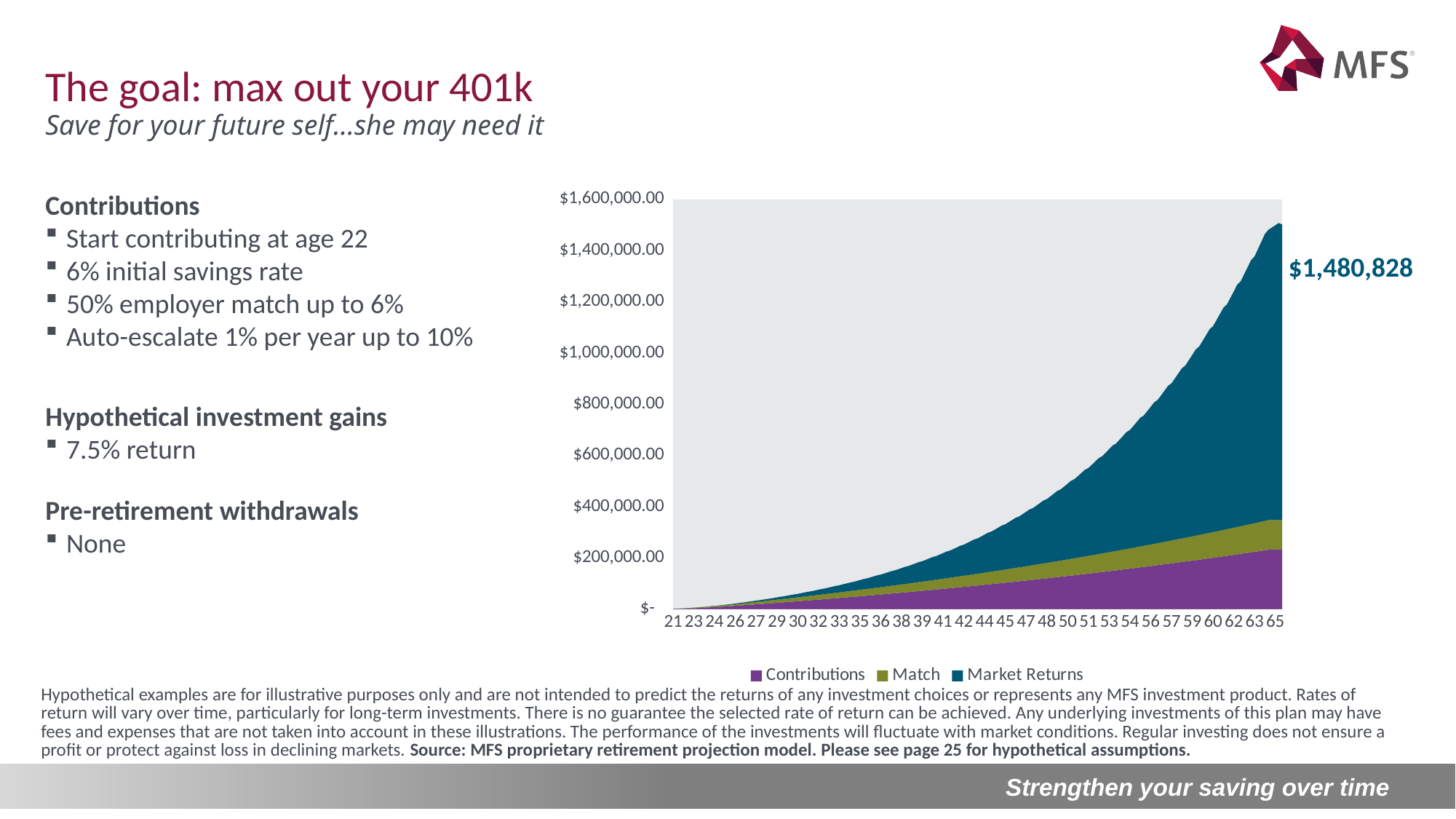
Is the total value at age 65 greater or less than $1,400,000? greater At age 65, which is larger: Contributions or Match? Contributions What kind of chart is shown on the slide? Stacked area chart Which series makes up the smallest portion of the total at age 65? Match Which series is plotted at the bottom of the stack? Contributions What is the first age shown on the x axis? 21 Which series makes up the largest portion of the total at age 65? Market Returns What total value is labelled at the end of the chart at age 65? $1,480,828 Does the total account value rise or fall as age increases along the x axis? Rises What are the series listed in the chart's legend? Contributions, Match, Market Returns Is the total value at age 45 greater or less than $400,000? less How many series does the chart's legend list? 3